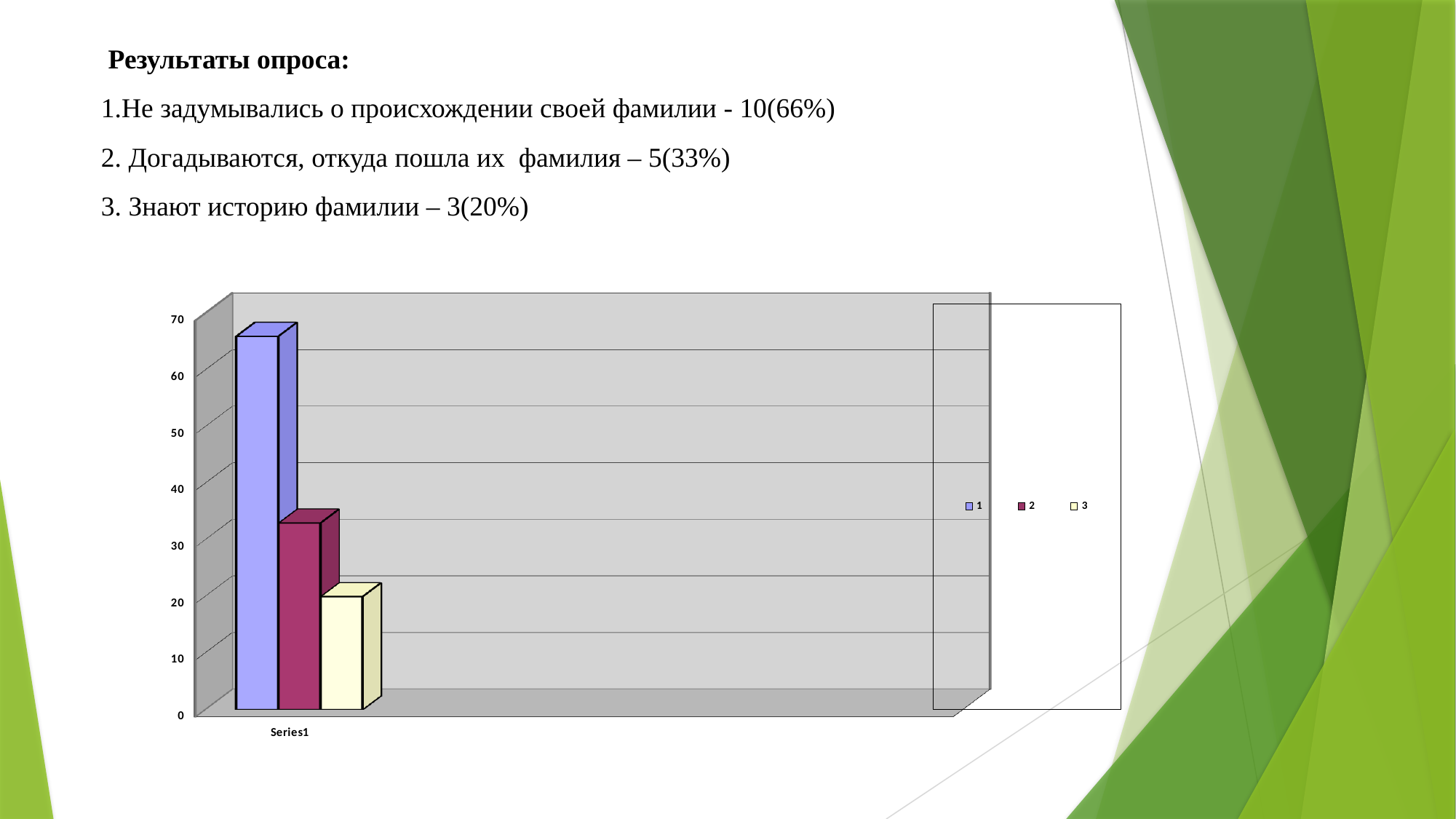
How many series does the chart legend list? 3 Is the value for series 2 greater or less than 30? greater What is the category label shown under the bars on the x axis? Series1 Which bar is taller, series 1 or series 2? series 1 What value does the bar for series 3 reach on the y axis? 20 What is the highest value shown on the chart's y axis? 70 Is the value for series 1 greater or less than 60? greater Which series has the tallest bar in the chart? 1 How many categories are shown on the x axis of the chart? 1 Which series has the shortest bar in the chart? 3 Is the value for series 2 greater or less than 40? less What kind of chart is shown on the slide? bar chart